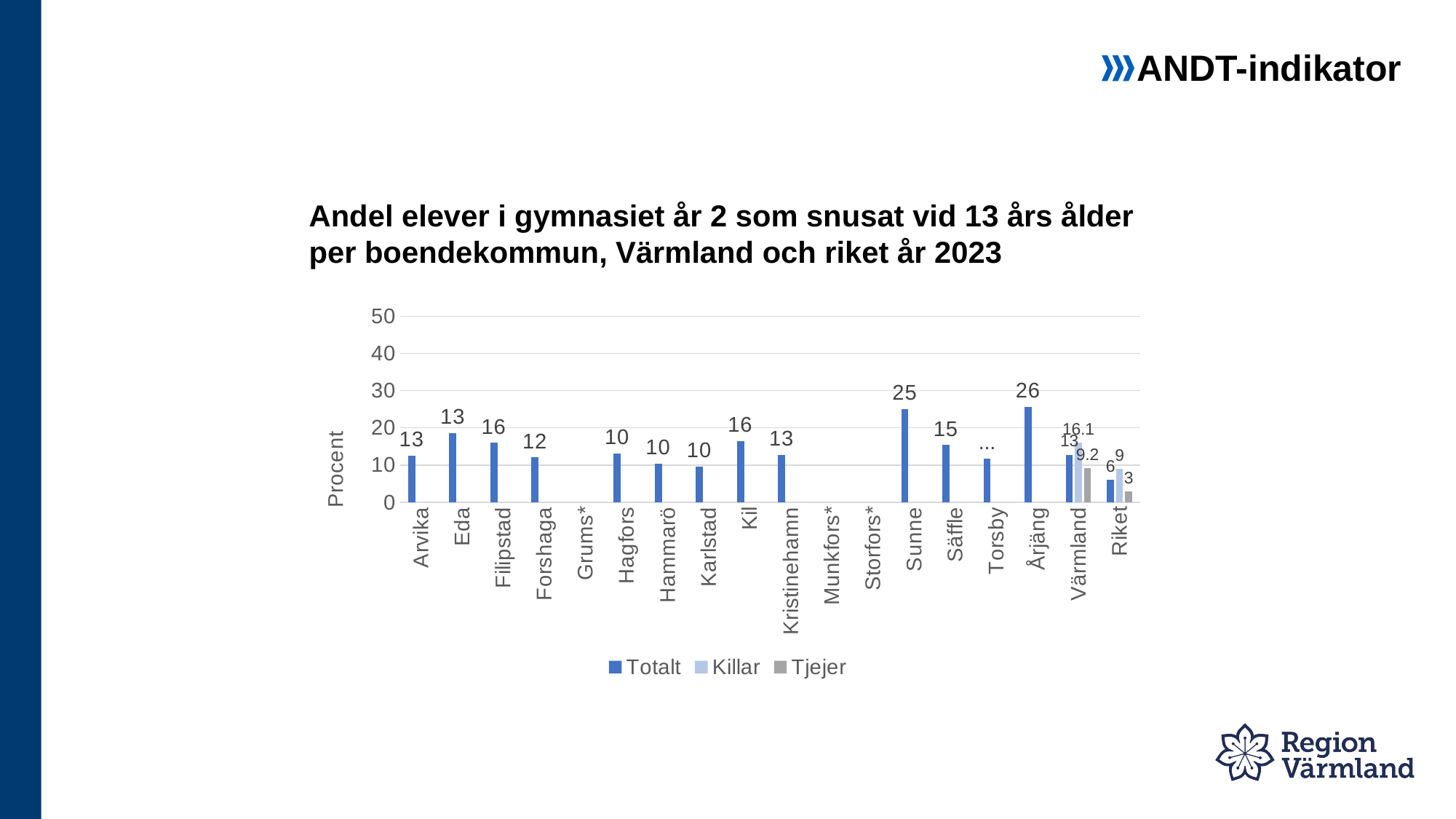
Which category has the highest Totalt value? Årjäng What is the difference between the Killar and Tjejer values for Värmland? 6.9 What is the Totalt value for Sunne? 25 What is the Tjejer value for Värmland? 9.2 What is the Killar value for Riket? 9 What kind of chart is shown on the slide? Bar chart What is the label on the y axis? Procent Which has the larger Totalt value, Filipstad or Forshaga? Filipstad How many categories are shown on the x axis? 18 Is the Totalt value for Sunne greater or less than 20? greater What is the difference between the Totalt values for Årjäng and Sunne? 1 How many series does the legend list? 3